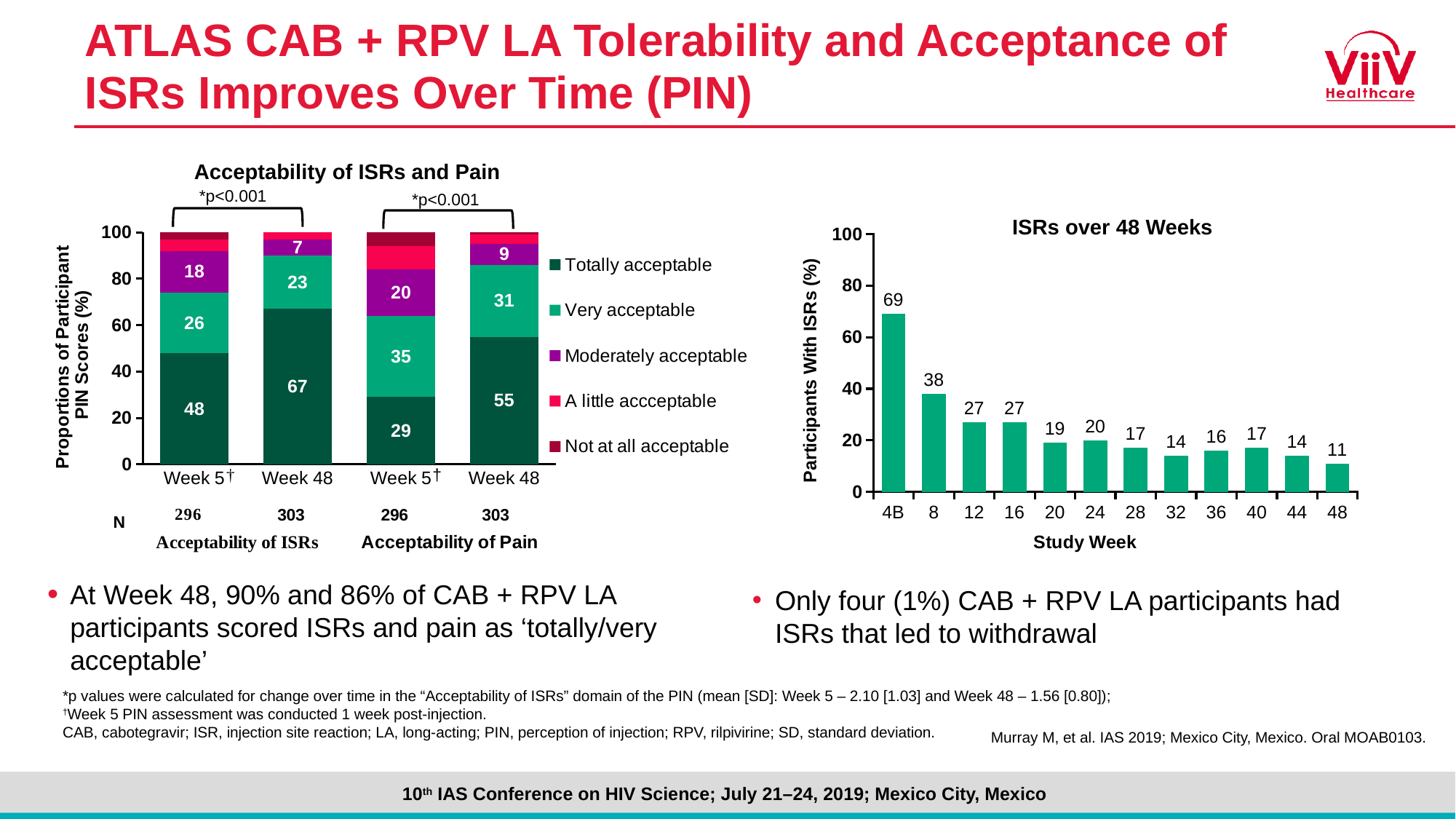
In the 'ISRs over 48 Weeks' chart, how many study week categories are shown on the x axis? 12 In the 'ISRs over 48 Weeks' chart, what is the difference between the values at week 4B and week 8? 31 In the 'Acceptability of ISRs and Pain' chart, which is larger: the 'Totally acceptable' share for Acceptability of Pain at Week 5 or at Week 48? Week 48 In the 'Acceptability of ISRs and Pain' chart, what percentage of participants rated ISRs as 'Totally acceptable' at Week 48? 67 In the 'Acceptability of ISRs and Pain' chart, how many series does the legend list? 5 In the 'ISRs over 48 Weeks' chart, what percentage of participants had ISRs at study week 4B? 69 In the 'Acceptability of ISRs and Pain' chart, what percentage of participants rated pain as 'Very acceptable' at Week 5? 35 In the 'ISRs over 48 Weeks' chart, which study week has the lowest percentage of participants with ISRs? 48 In the 'ISRs over 48 Weeks' chart, what is the value at study week 48? 11 In the 'ISRs over 48 Weeks' chart, do the values generally rise or fall from week 4B to week 48? fall In the 'ISRs over 48 Weeks' chart, which study week has the highest percentage of participants with ISRs? 4B What kind of chart is the 'ISRs over 48 Weeks' chart? bar chart